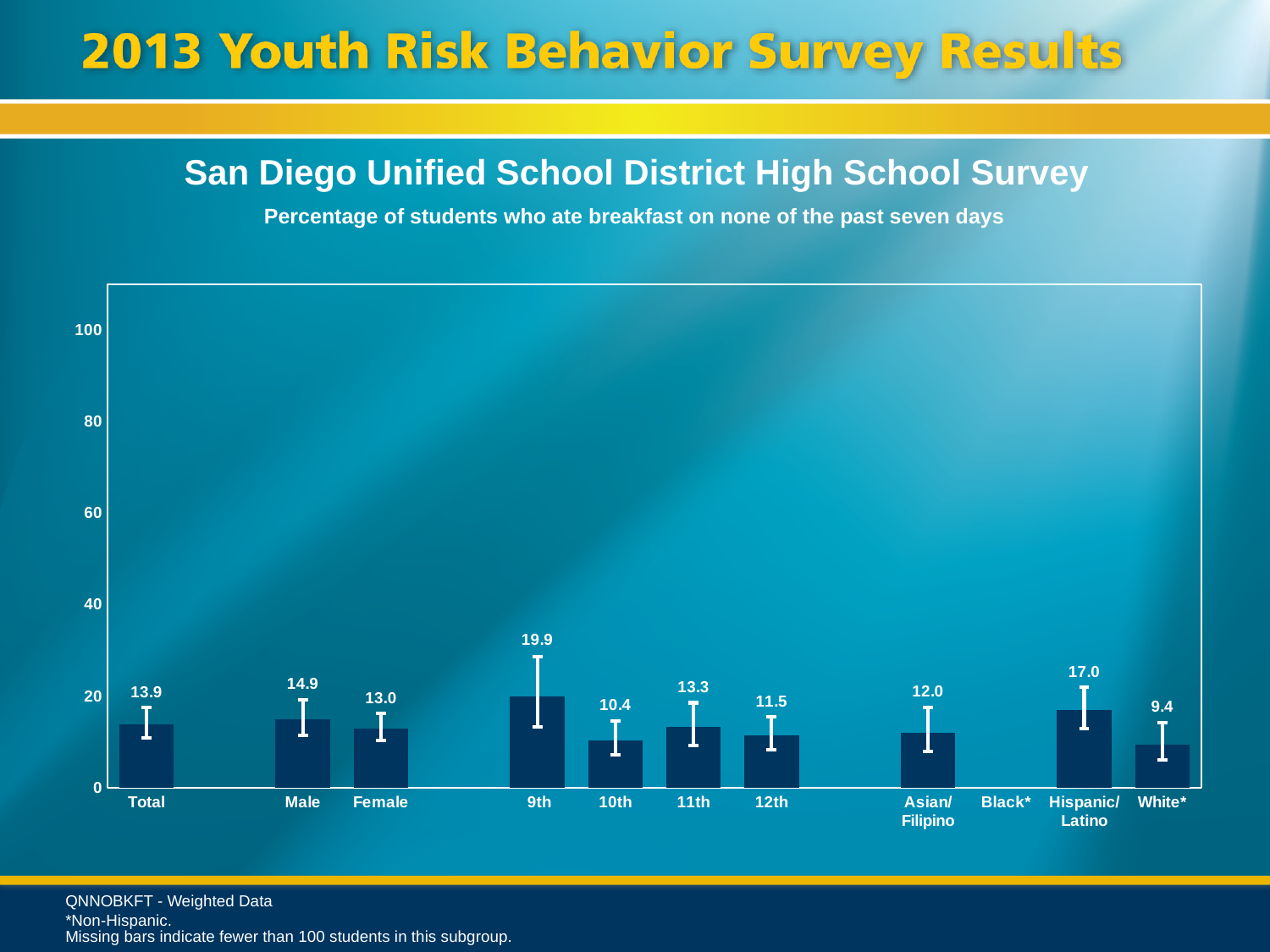
What kind of chart is shown? bar chart Which is larger, the value for 10th grade or 11th grade? 11th What is the value for White*? 9.4 Which category label has no bar plotted? Black* What is the difference between the Male and Female values? 1.9 What is the value for Total? 13.9 Which category with a plotted bar has the lowest value? White* What is the value for 9th grade? 19.9 Which category has the highest value? 9th What is the value for Hispanic/Latino? 17.0 How many bars are plotted on the chart? 10 Is the value for 9th grade greater or less than 20? less